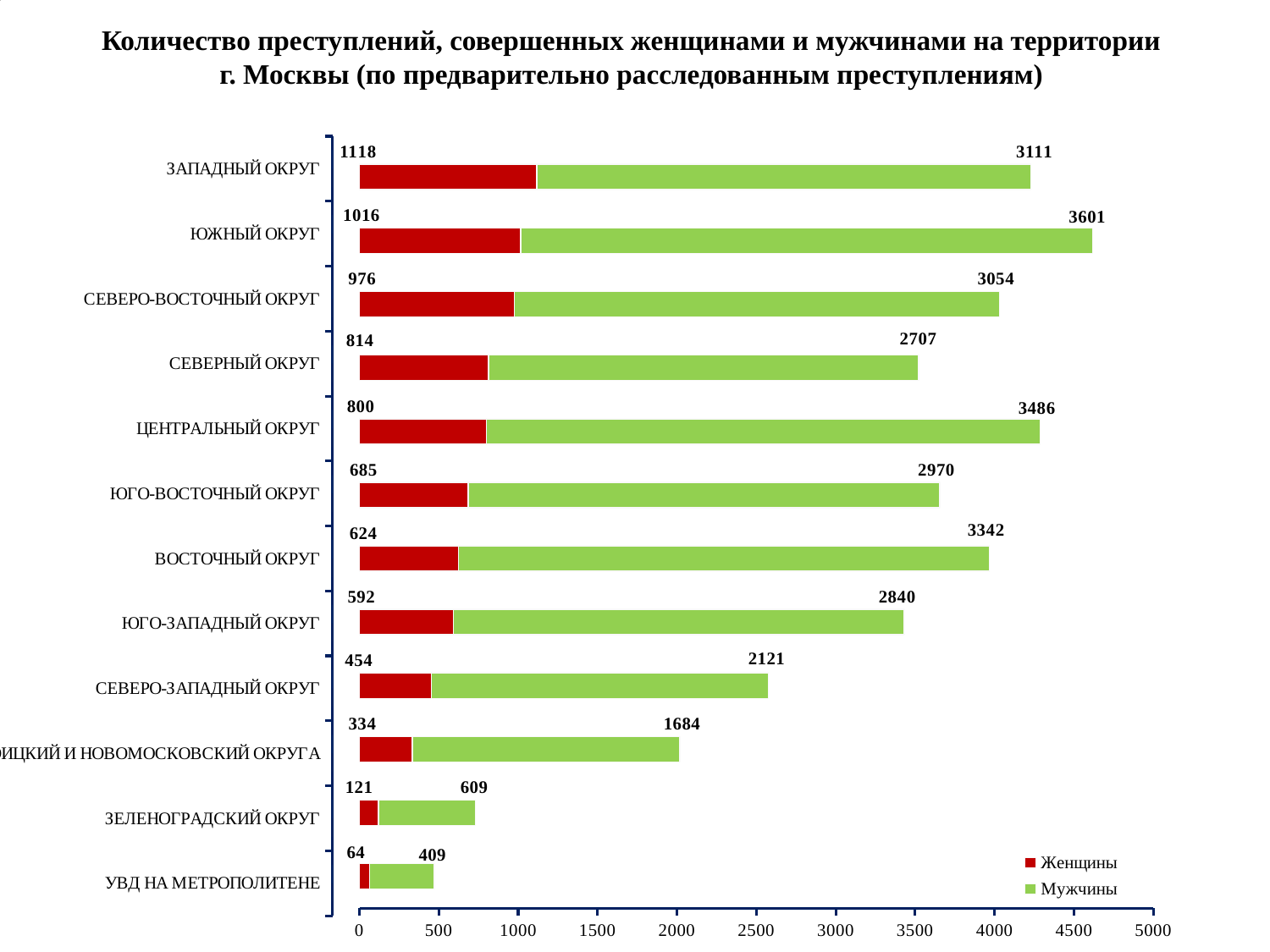
How many series does the legend list? 2 How many categories (districts) are shown on the chart? 12 What is the value for Женщины in ЗАПАДНЫЙ ОКРУГ? 1118 Which category has the lowest value for Женщины? УВД НА МЕТРОПОЛИТЕНЕ Which is larger: the Мужчины value for ЦЕНТРАЛЬНЫЙ ОКРУГ or for ВОСТОЧНЫЙ ОКРУГ? ЦЕНТРАЛЬНЫЙ ОКРУГ Which district has the highest value for Мужчины? ЮЖНЫЙ ОКРУГ What is the difference between the Женщины values for ЗАПАДНЫЙ ОКРУГ and ЮЖНЫЙ ОКРУГ? 102 Which colour represents the Женщины series in the legend? Red Is the total of the stacked bar for ЗЕЛЕНОГРАДСКИЙ ОКРУГ greater or less than 500? greater What is the total of the stacked bar for ЮЖНЫЙ ОКРУГ? 4617 What type of chart is shown on the slide? Stacked horizontal bar chart What is the value for Мужчины in СЕВЕРНЫЙ ОКРУГ? 2707